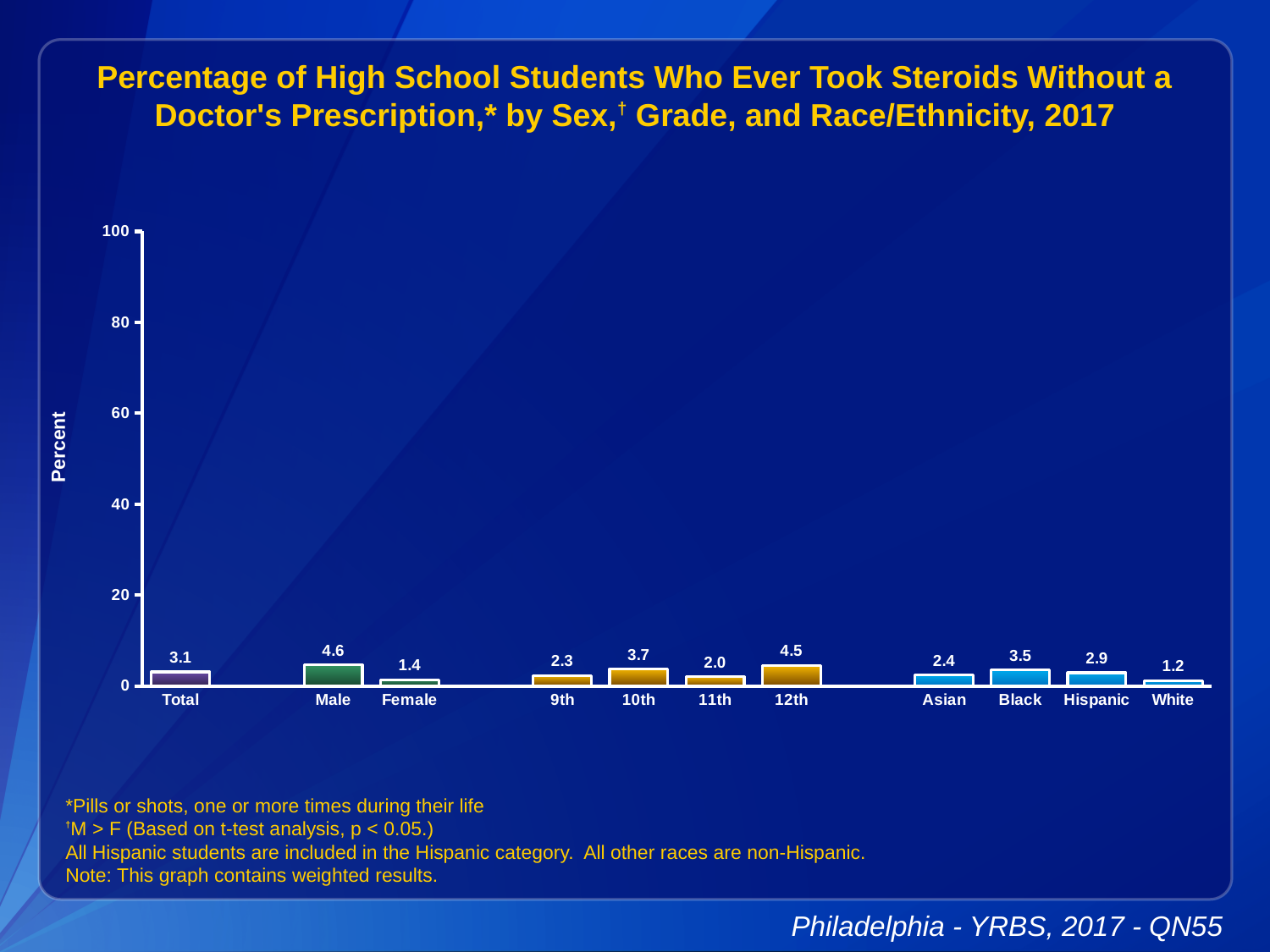
Which category has the highest value? Male Which is larger, the value for 10th grade or the value for 11th grade? 10th Is the value for Black students greater or less than 20? less Which category has the lowest value? White How many categories are shown on the x axis? 11 What is the value for 12th grade? 4.5 What is the value for Male? 4.6 What is the value for Hispanic students? 2.9 What is the difference between the Male and Female values? 3.2 What kind of chart is shown? bar chart What is the value for Total? 3.1 What is the label of the y axis? Percent